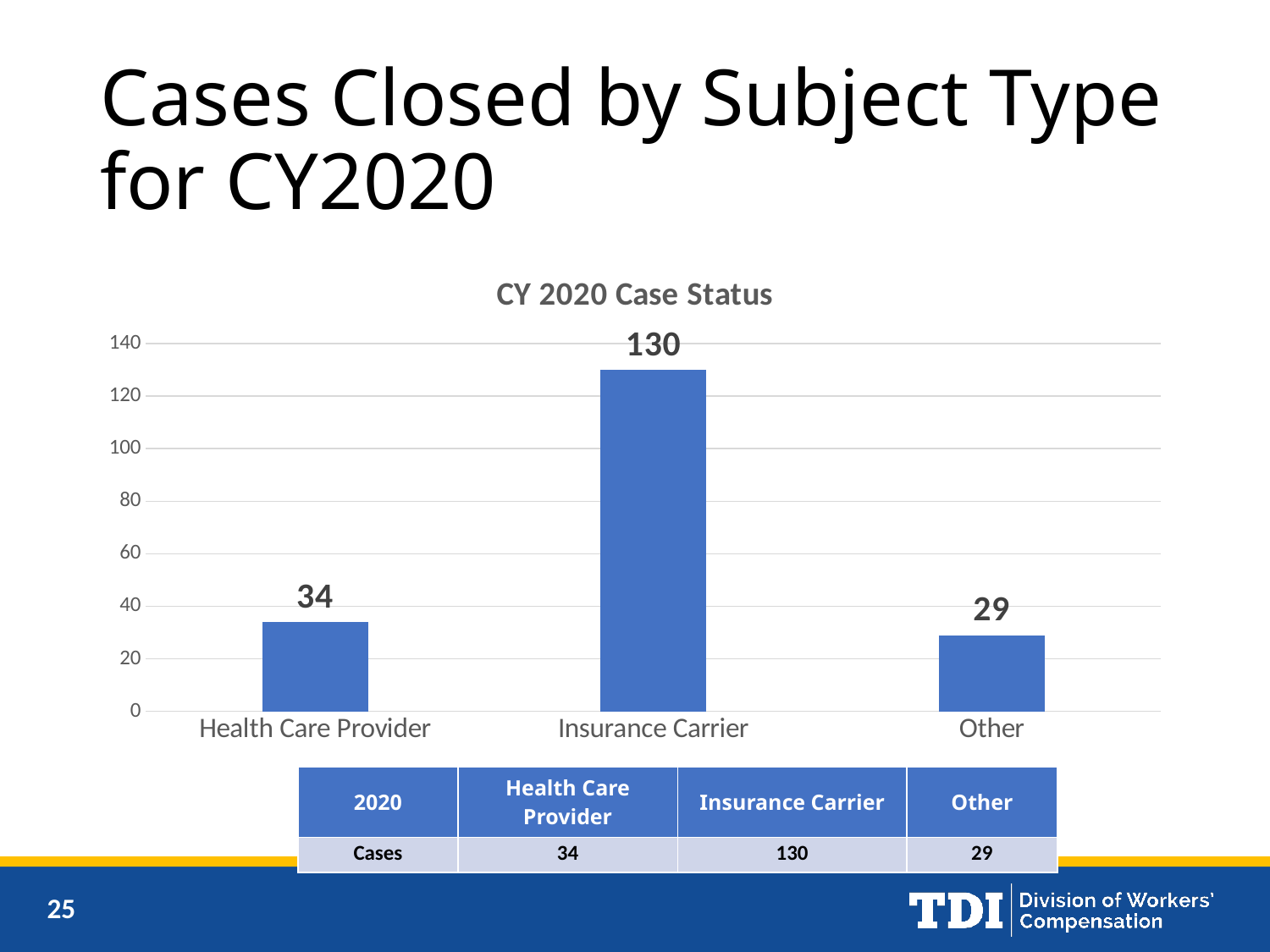
What kind of chart is shown? bar chart Which category has the lowest value? Other Which category has the highest value? Insurance Carrier Which is larger, the value for Health Care Provider or the value for Other? Health Care Provider What is the value for Health Care Provider? 34 What is the difference between the values for Insurance Carrier and Health Care Provider? 96 What is the difference between the values for Health Care Provider and Other? 5 What is the title of the chart? CY 2020 Case Status How many categories are shown on the x axis? 3 What is the value for Other? 29 Is the value for Insurance Carrier greater or less than 120? greater What is the value for Insurance Carrier? 130